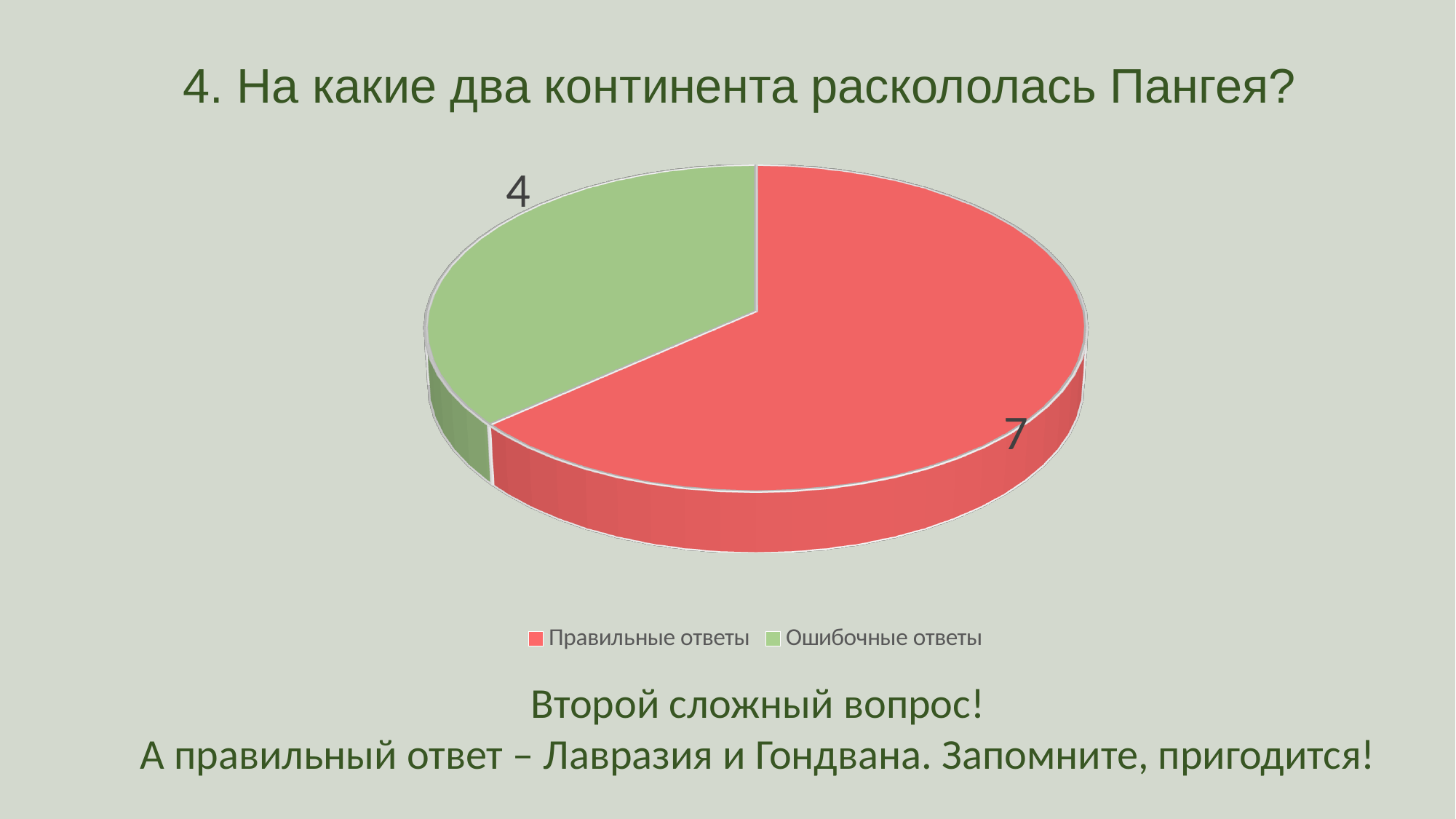
What kind of chart is shown on the slide? Pie chart How many entries does the chart legend list? 2 What value is shown for the "Правильные ответы" slice of the pie chart? 7 What is the difference between the values for "Правильные ответы" and "Ошибочные ответы"? 3 Which category has the smallest slice in the pie chart? Ошибочные ответы What value is shown for the "Ошибочные ответы" slice of the pie chart? 4 How many slices does the pie chart have? 2 What is the total of all the values shown in the pie chart? 11 What colour is the "Ошибочные ответы" slice in the pie chart? Green Which is larger: the value for "Правильные ответы" or the value for "Ошибочные ответы"? Правильные ответы Which category has the largest slice in the pie chart? Правильные ответы